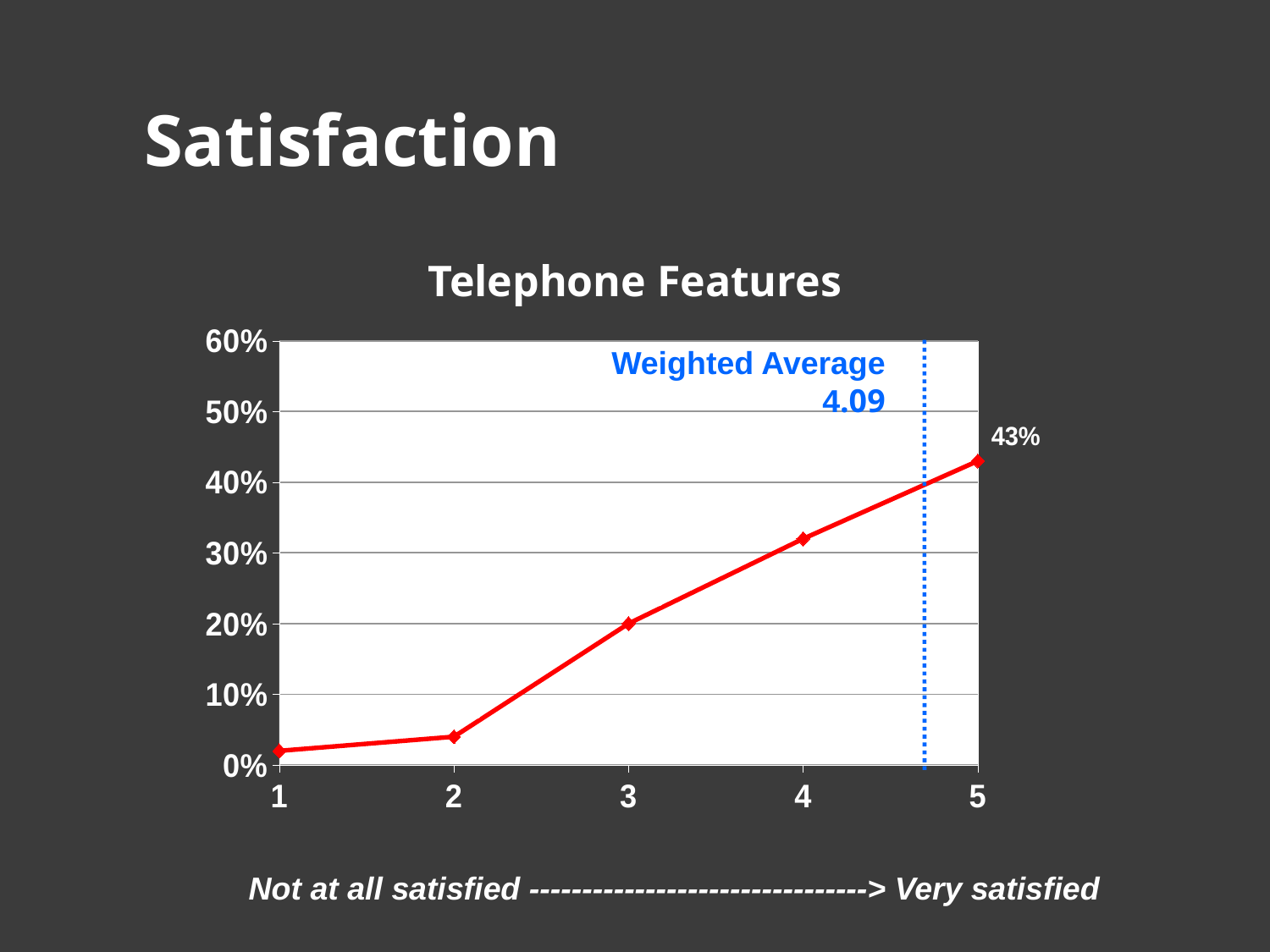
Is the value for category 3 greater or less than 10%? greater Which has the larger value, category 4 or category 2? 4 What is the title of the chart? Telephone Features Which category has the lowest value in the Telephone Features chart? 1 How many data points are plotted in the Telephone Features chart? 5 Is the value for category 4 greater or less than 30%? greater Which category has the highest value in the Telephone Features chart? 5 What kind of chart is shown on the slide? Line chart Is the value for category 2 greater or less than 10%? less What is the value for category 5 in the Telephone Features chart? 43% What weighted average is annotated on the chart? 4.09 Do the values rise or fall as the x axis goes from 1 to 5? Rise